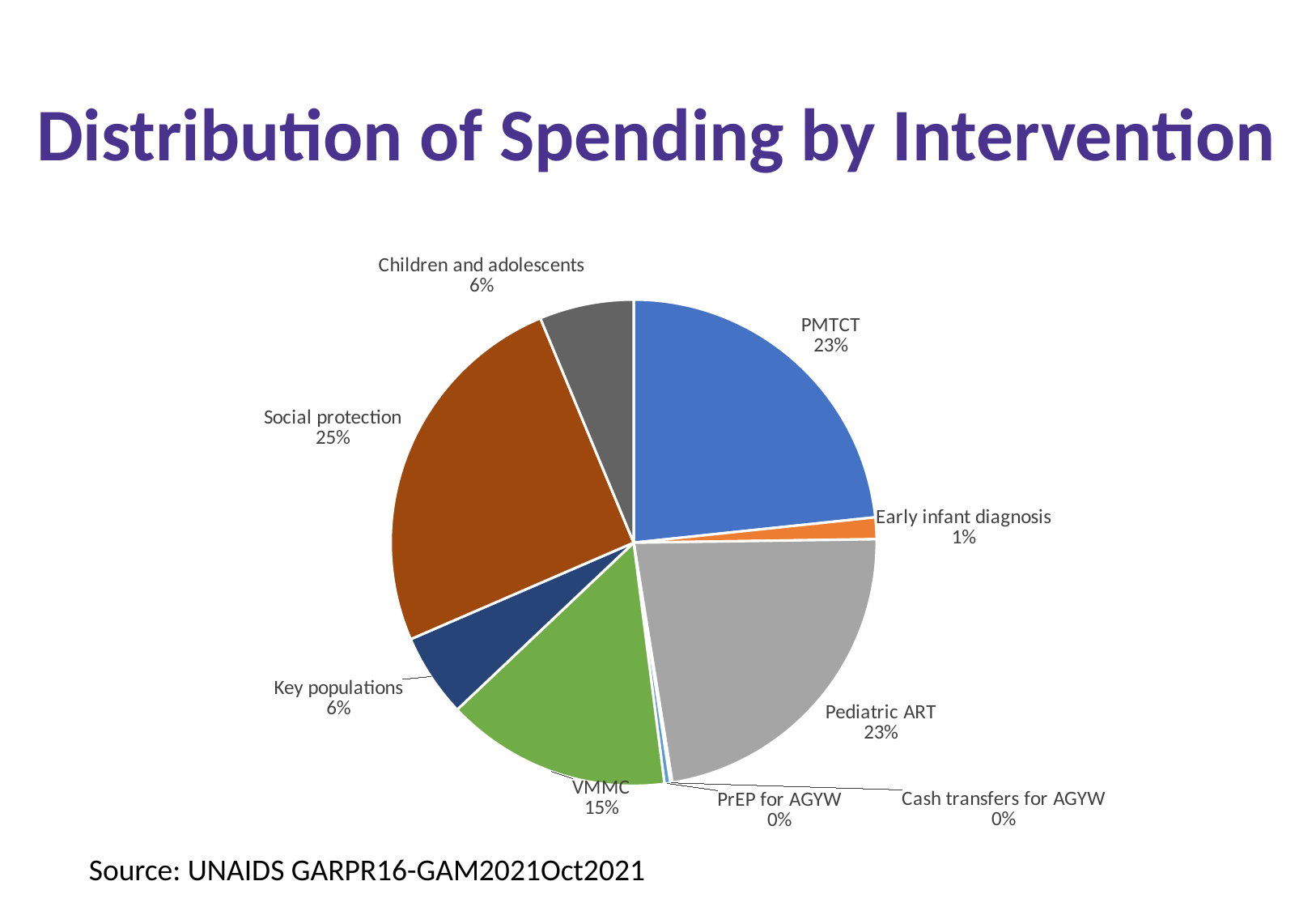
Which intervention has the largest share of spending? Social protection What is the title of the chart? Distribution of Spending by Intervention What percentage is shown for Key populations? 6% What is the difference in share between Social protection and VMMC? 10% What type of chart is shown on the slide? Pie chart What share of spending is for Early infant diagnosis? 1% Which has a larger share of spending, Social protection or PMTCT? Social protection What share is shown for PrEP for AGYW? 0% What share of spending goes to Social protection? 25% What is the difference in share between PMTCT and Early infant diagnosis? 22% How many interventions are shown in the pie chart? 9 What percentage of spending is for VMMC? 15%